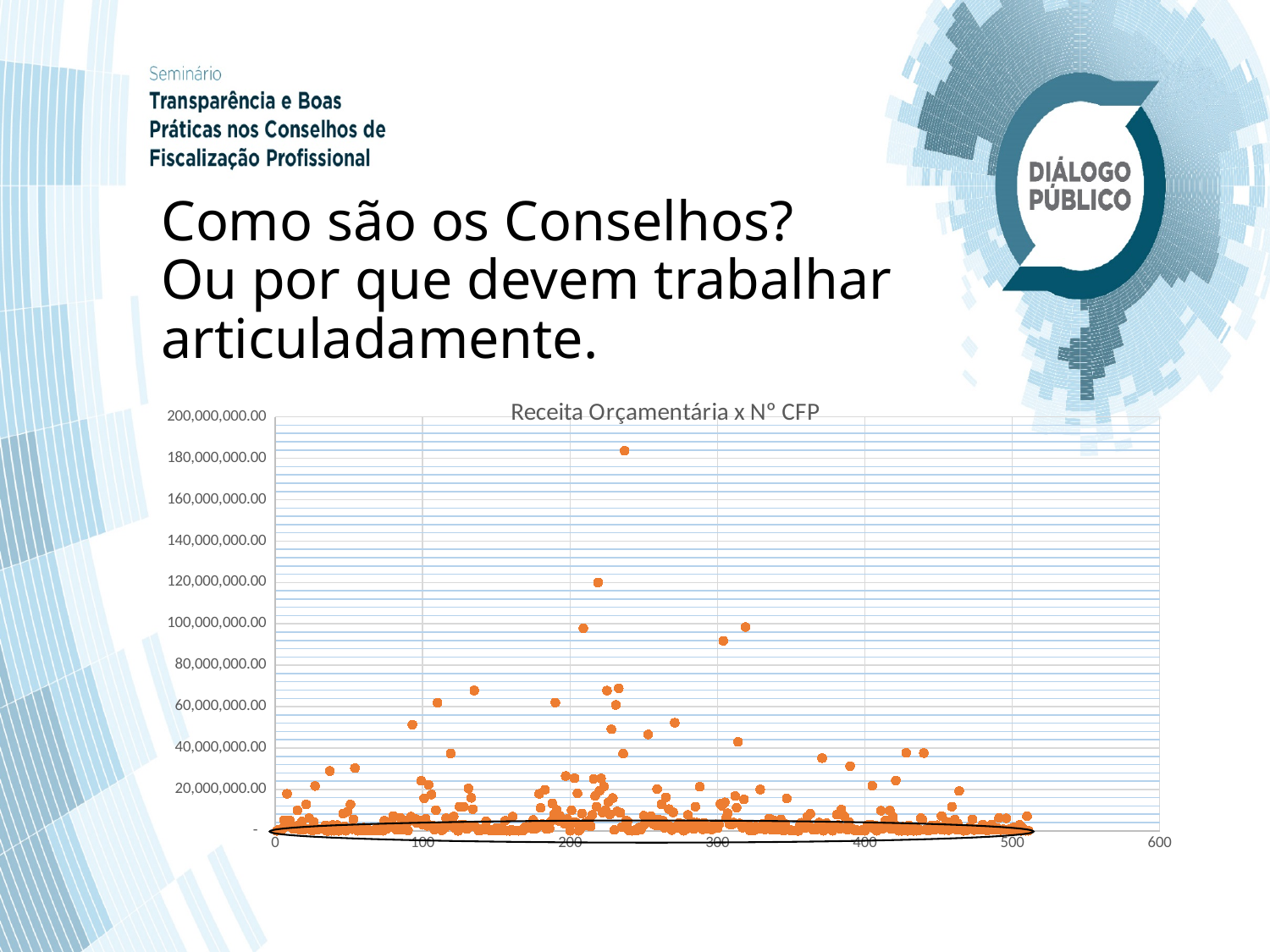
Are there any plotted points beyond 550 on the horizontal axis? No Is the horizontal-axis position of the highest plotted point greater or less than 300? less What kind of chart is shown on the slide? scatter chart Is the second-highest plotted point greater or less than 100,000,000.00? greater What is the highest value shown on the vertical axis of the chart? 200,000,000.00 What is the title of the chart? Receita Orçamentária x N° CFP How many plotted points lie above 100,000,000.00 on the vertical axis? 2